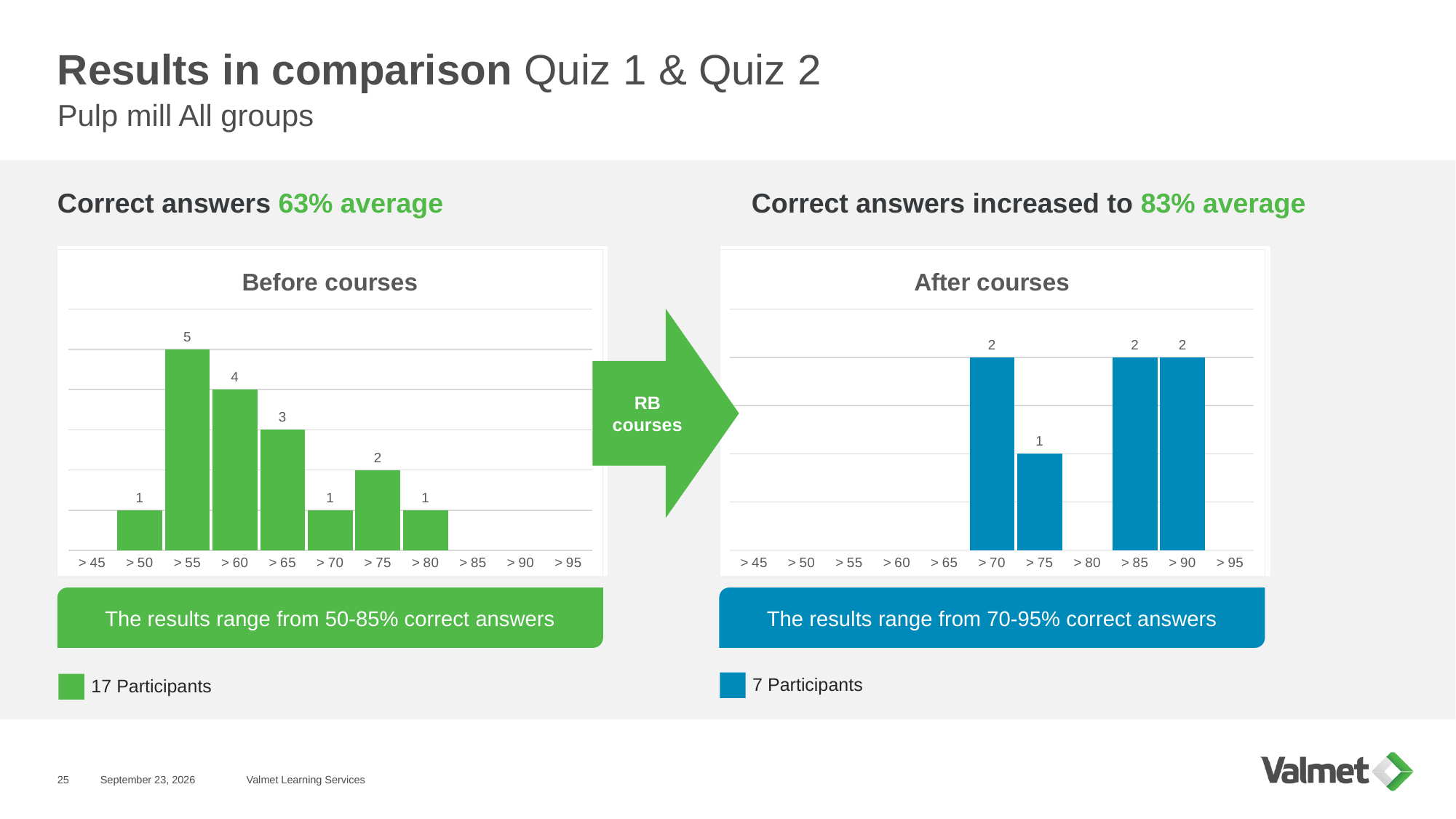
In the "Before courses" chart, do the values rise or fall from "> 55" to "> 70"? Fall In the "Before courses" chart, what is the value for the "> 55" category? 5 In the "Before courses" chart, which category has the highest value? > 55 In the "Before courses" chart, which is larger, the value for "> 60" or the value for "> 70"? > 60 In the "After courses" chart, what is the value for the "> 75" category? 1 In the "After courses" chart, which category has the lowest non-zero value? > 75 In the "After courses" chart, what is the difference between the values for "> 70" and "> 75"? 1 What colour are the bars in the "After courses" chart? Blue In the "Before courses" chart, what is the value for the "> 75" category? 2 What kind of chart is the "After courses" chart? Bar chart How many categories are shown on the x axis of the "Before courses" chart? 11 In the "Before courses" chart, what is the difference between the values for "> 55" and "> 65"? 2